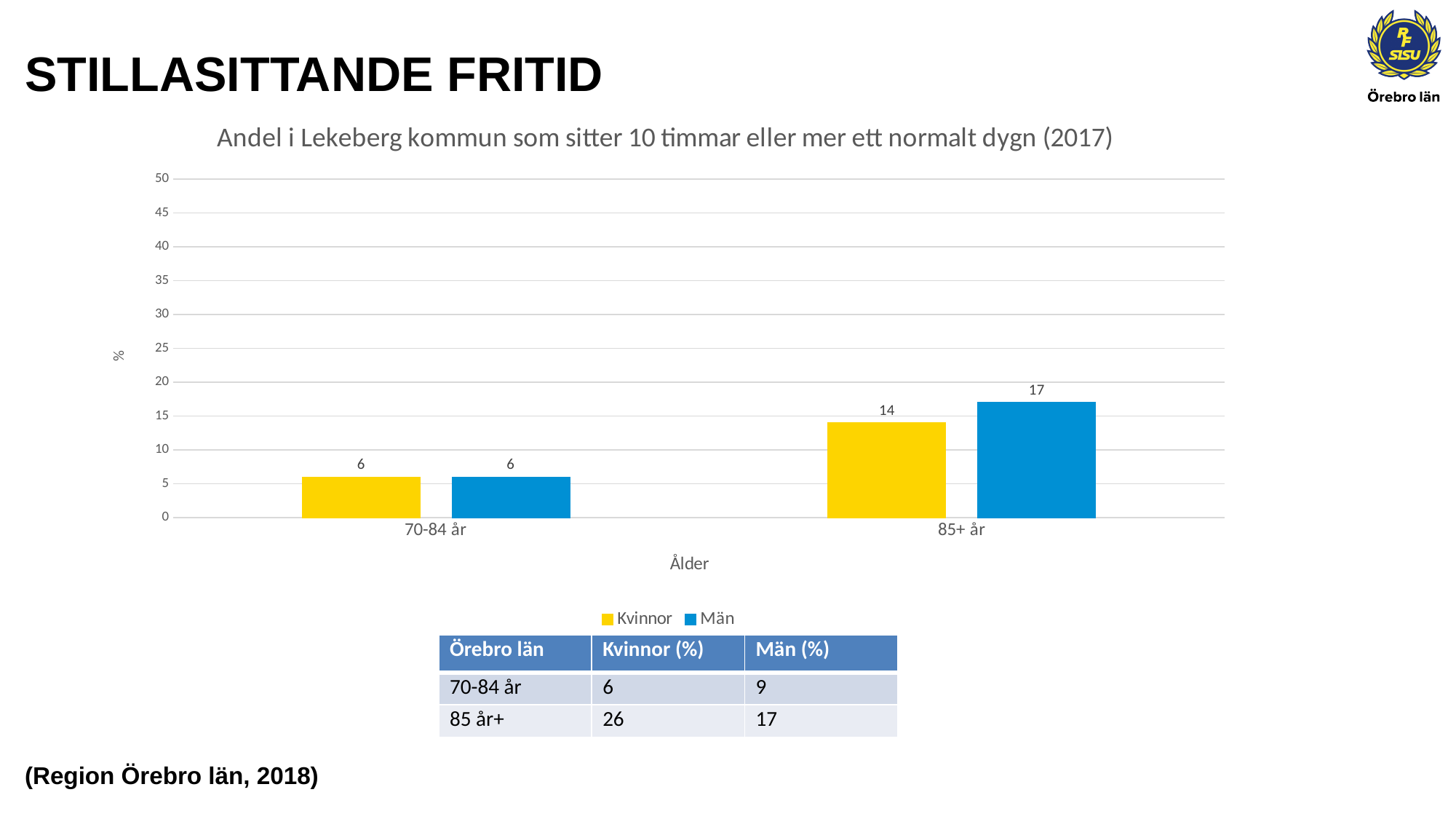
Which age category has the lowest value for Kvinnor? 70-84 år What is the difference between the Män and Kvinnor values in the 85+ år category? 3 What is the value for Kvinnor in the 70-84 år category? 6 Which age category has the highest value for Män? 85+ år What is the value for Kvinnor in the 85+ år category? 14 How many age categories are shown on the x axis? 2 How many series does the legend list? 2 In the 85+ år category, which series has the larger value, Kvinnor or Män? Män What kind of chart is shown on the slide? bar chart What colour are the Kvinnor bars? yellow What is the value for Män in the 85+ år category? 17 Is the value for Män in the 85+ år category greater or less than 20? less